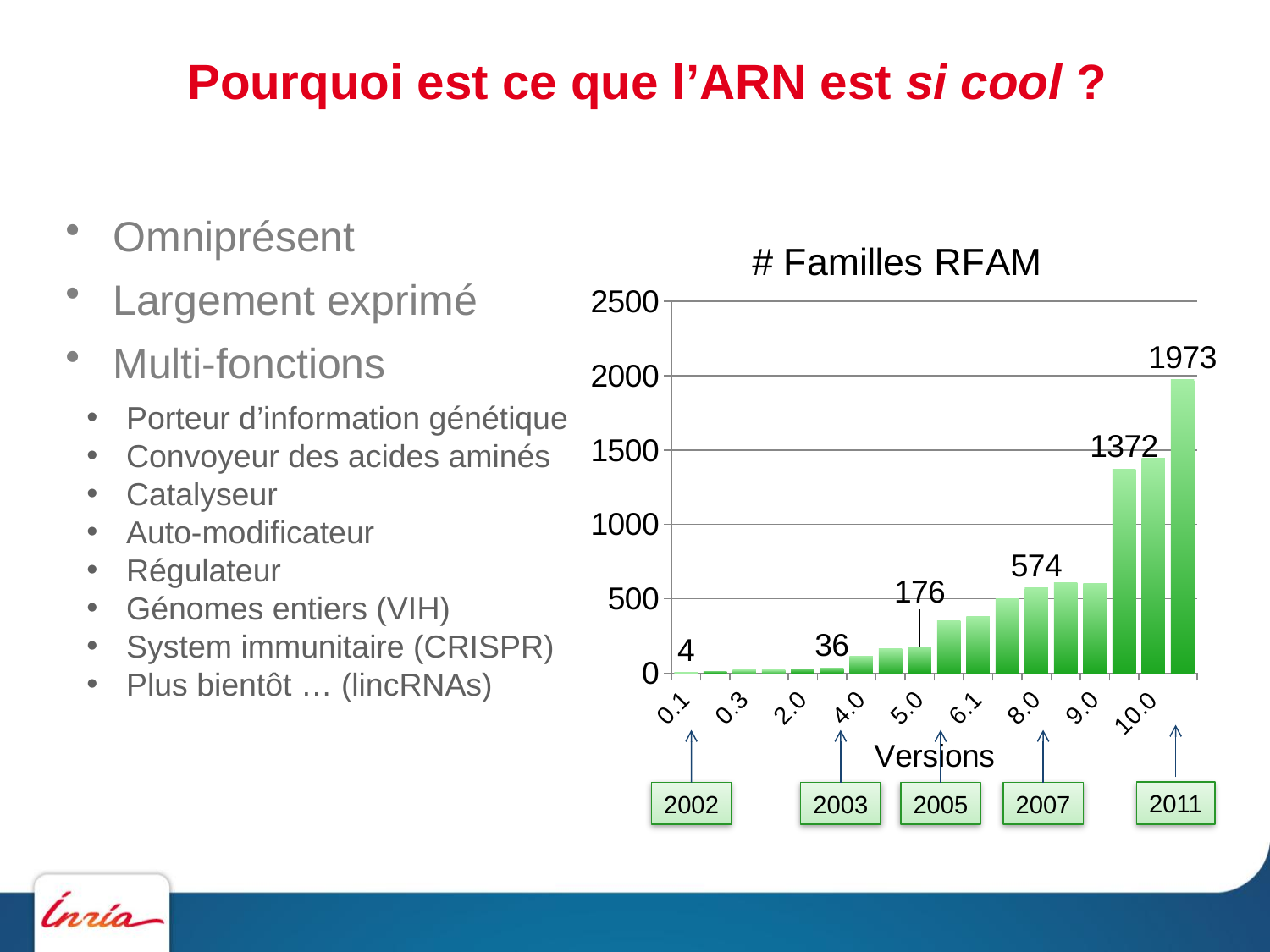
What is the label of the x axis of the chart? Versions Is the value for version 6.1 greater or less than 1000? less What is the difference between the labelled values 574 and 176? 398 What is the difference between the two largest labelled values, 1973 and 1372? 601 What is the number of RFAM families for version 5.0? 176 What is the lowest value labelled in the chart? 4 What is the number of RFAM families for version 0.1? 4 What is the title of the chart on the slide? # Familles RFAM Do the values generally rise or fall as the version number increases along the x axis? rise What is the highest value shown in the chart? 1973 What type of chart is shown on the slide? bar chart